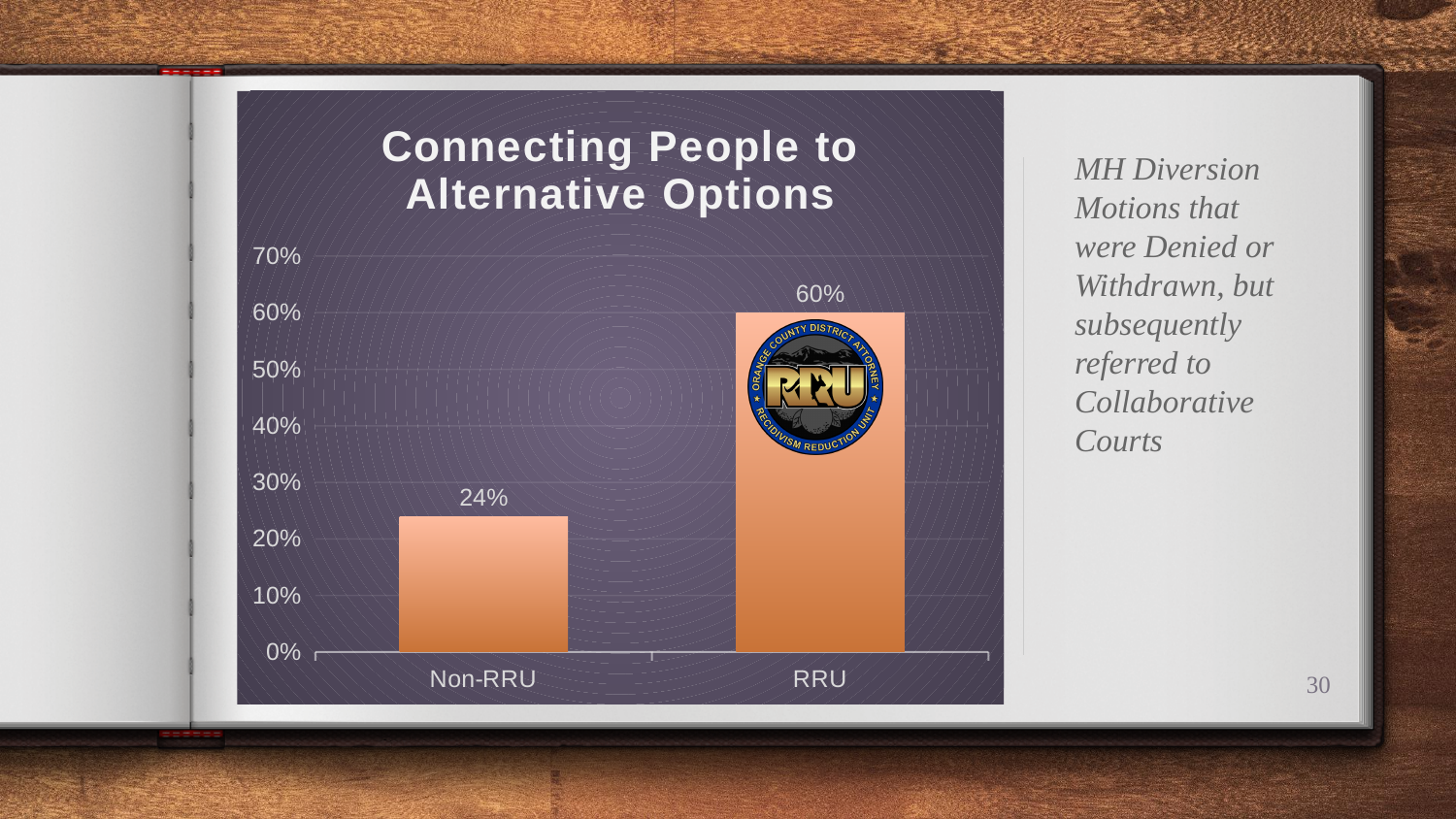
Which category has the lowest value? Non-RRU What is the title of the chart? Connecting People to Alternative Options Is the value for RRU greater or less than 50%? greater What kind of chart is shown? bar chart Which is larger, the value for RRU or the value for Non-RRU? RRU What is the highest value shown on the y axis? 70% Which category has the highest value? RRU What is the value for RRU? 60% Is the value for Non-RRU greater or less than 30%? less What is the value for Non-RRU? 24% What is the difference between the RRU and Non-RRU values? 36% How many categories are shown on the x axis? 2